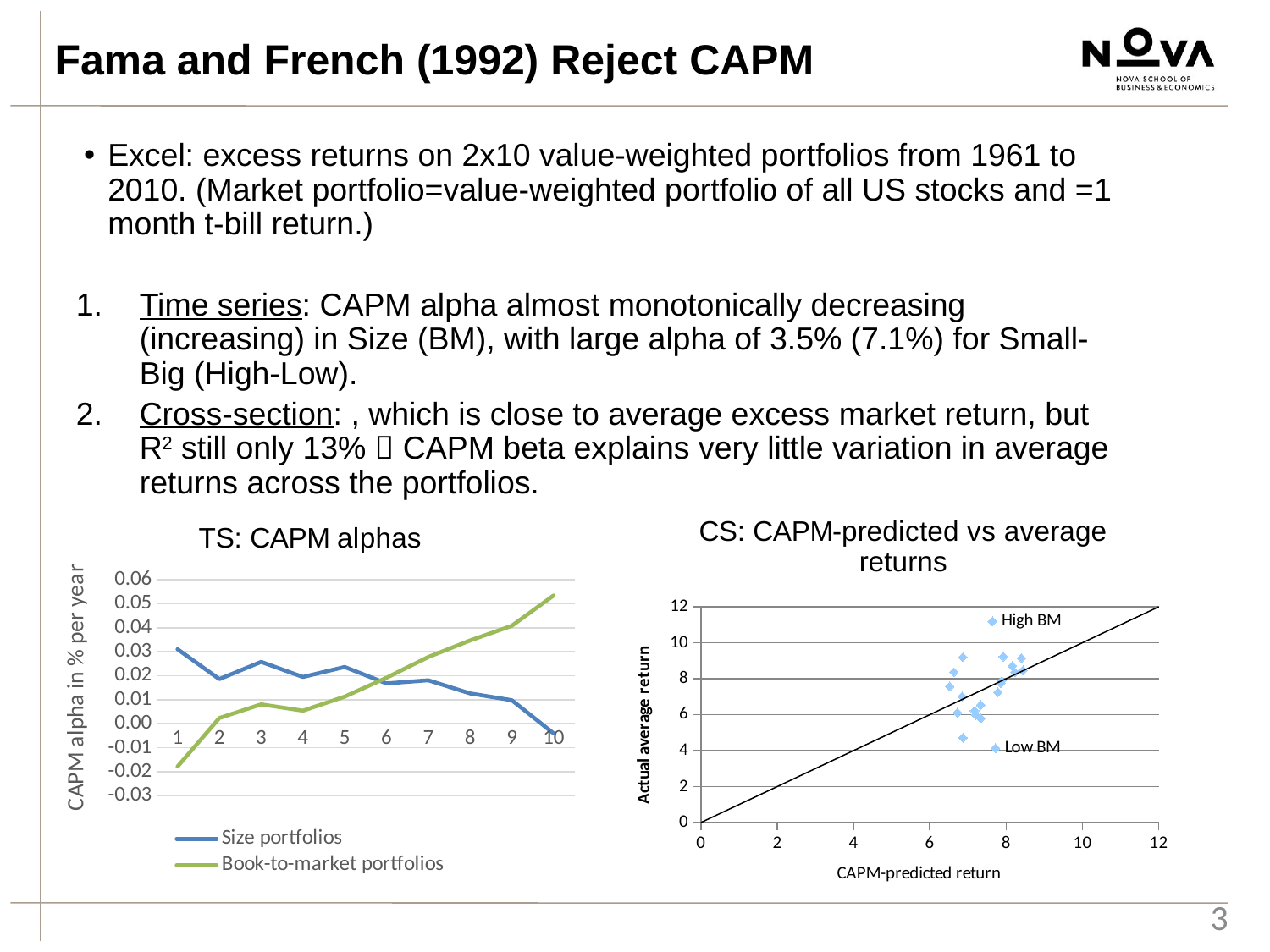
In the 'TS: CAPM alphas' chart, how many portfolio points are plotted along the x axis for each series? 10 In the 'TS: CAPM alphas' chart, does the Size portfolios line generally rise or fall from portfolio 1 to portfolio 10? fall In the 'CS: CAPM-predicted vs average returns' chart, what is the label of the vertical axis? Actual average return What kind of chart is the 'TS: CAPM alphas' chart? line chart In the 'TS: CAPM alphas' chart, is the Book-to-market portfolios value at portfolio 1 greater or less than 0.00? less What kind of chart is the 'CS: CAPM-predicted vs average returns' chart? scatter chart In the 'TS: CAPM alphas' chart, is the Book-to-market portfolios value at portfolio 10 greater or less than 0.04? greater In the 'TS: CAPM alphas' chart, does the Book-to-market portfolios line generally rise or fall from portfolio 1 to portfolio 10? rise In the 'CS: CAPM-predicted vs average returns' chart, is the actual average return of the High BM point greater or less than 10? greater How many series does the legend of the 'TS: CAPM alphas' chart list? 2 In the 'TS: CAPM alphas' chart, which series has the higher value at portfolio 1, Size portfolios or Book-to-market portfolios? Size portfolios